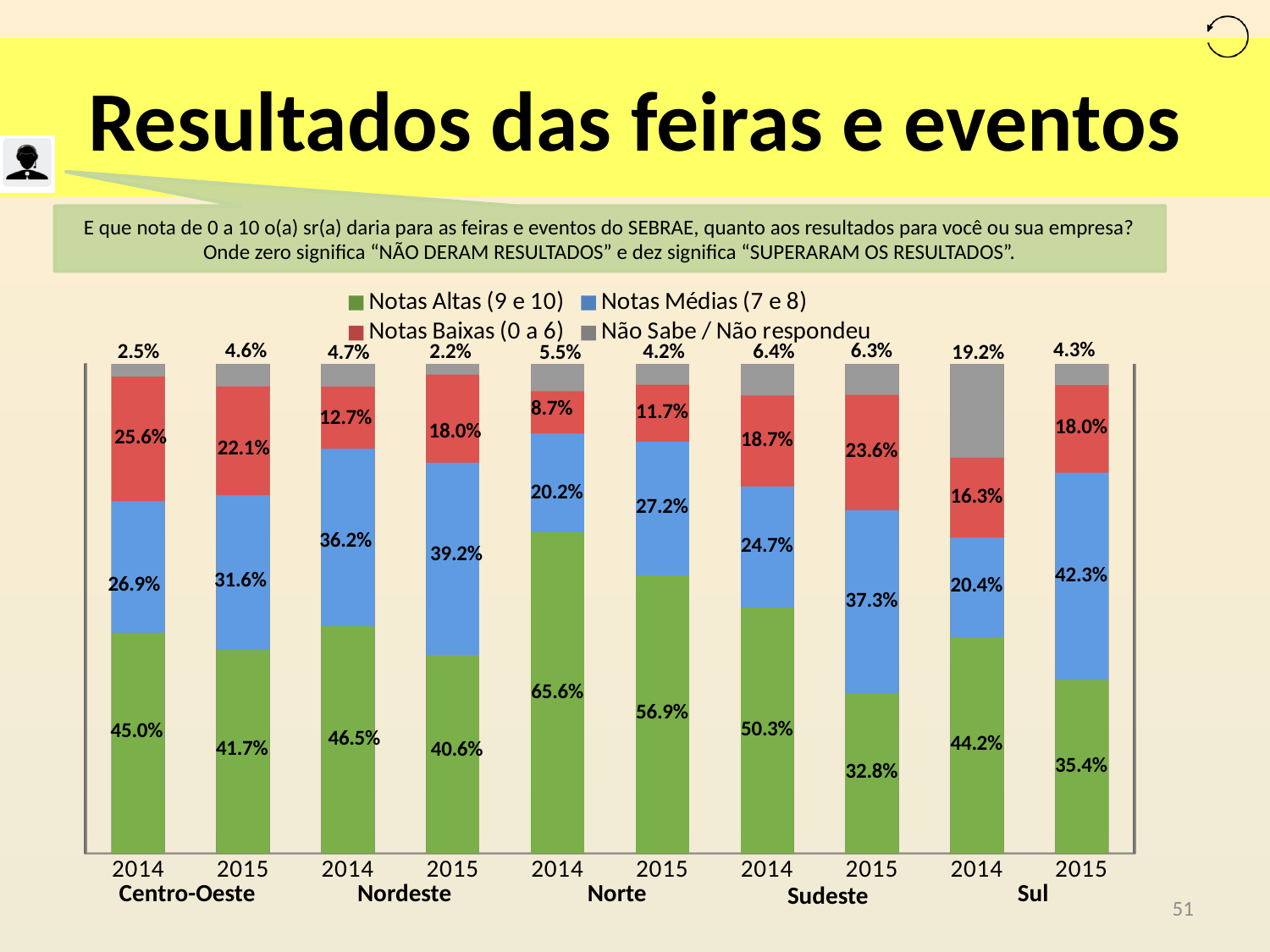
Which bar has the lowest value for Não Sabe / Não respondeu? Nordeste 2015 How many series does the legend list? 4 What is the difference between the Notas Altas (9 e 10) values for Norte in 2014 and 2015? 8.7% Which bar has the lowest value for Notas Altas (9 e 10)? Sudeste 2015 What kind of chart is shown on the slide? Stacked bar chart Which is larger: Notas Médias (7 e 8) for Sudeste 2015 or Notas Médias (7 e 8) for Sudeste 2014? Sudeste 2015 What is the value of Notas Altas (9 e 10) for Norte in 2014? 65.6% Which bar has the highest value for Notas Altas (9 e 10)? Norte 2014 How many bars are plotted in the chart? 10 What is the value of Notas Baixas (0 a 6) for Centro-Oeste in 2014? 25.6% What is the value of Não Sabe / Não respondeu for Sul in 2014? 19.2% What is the value of Notas Médias (7 e 8) for Sul in 2015? 42.3%